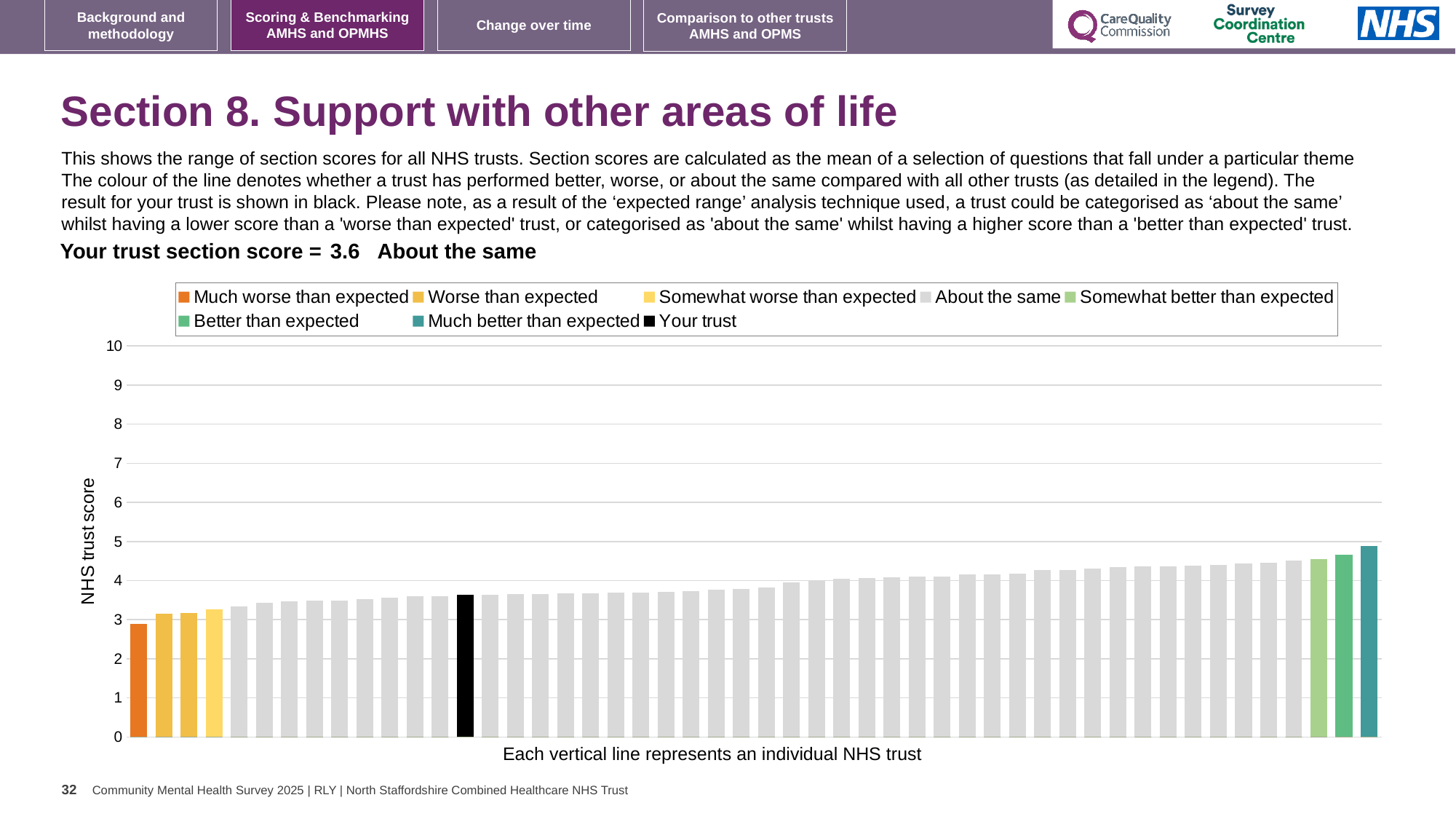
Do the bar values rise or fall from left to right along the x axis? rise Is the value of the shortest bar (the 'Much worse than expected' trust) greater or less than 4? less What is the section score for your trust (the black bar)? 3.6 What kind of chart is shown on the slide? bar chart What is the label on the vertical axis of the chart? NHS trust score How many entries does the chart legend list? 8 Is the value for your trust (the black bar) greater or less than 3? greater Which is larger: the value of the black 'Your trust' bar or the value of the orange 'Much worse than expected' bar? Your trust Is the value of the tallest bar (the 'Much better than expected' trust) greater or less than 4? greater What is the highest value shown on the vertical axis? 10 How many bars are coloured as 'Much worse than expected' (orange)? 1